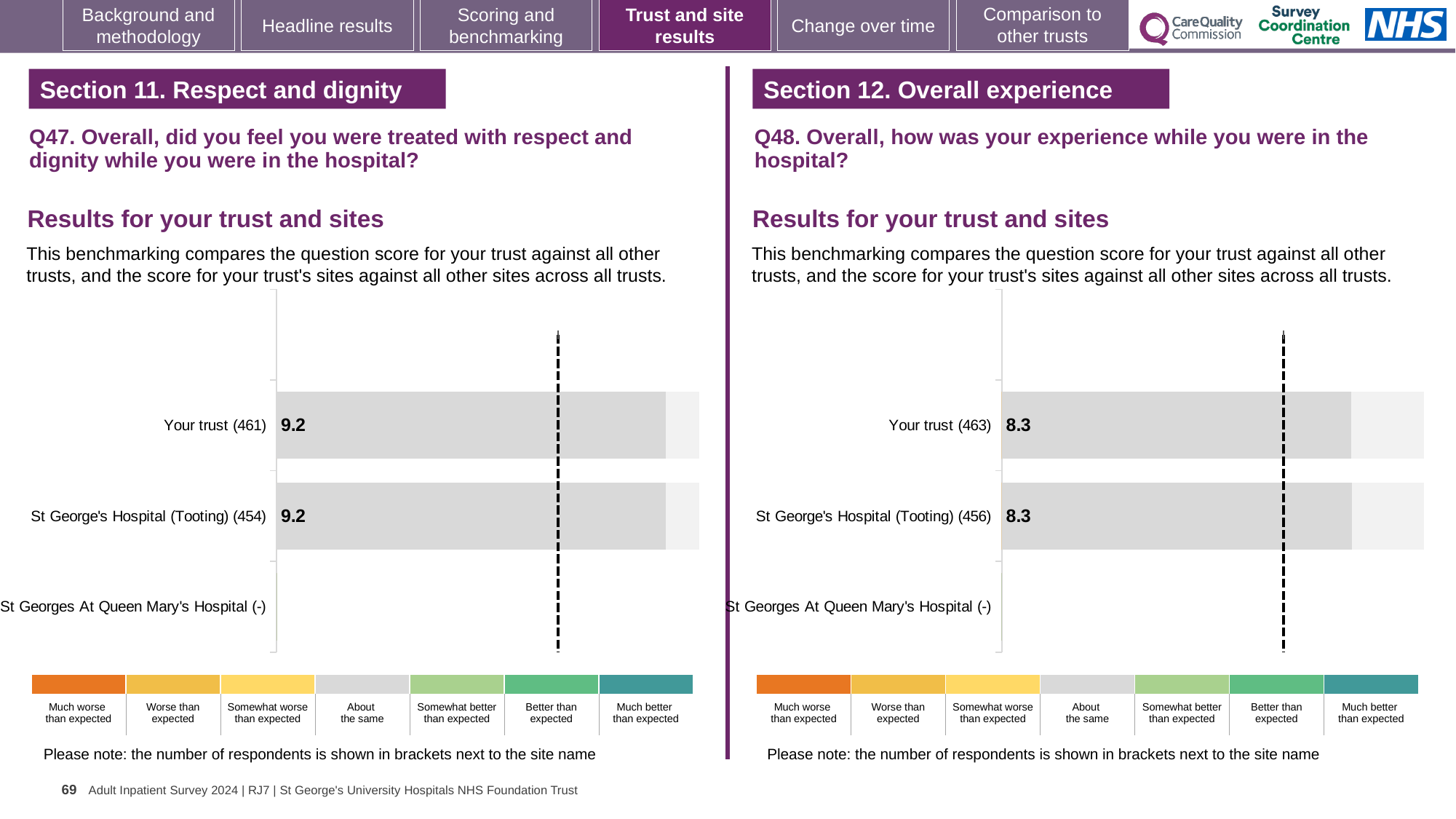
On the left chart (Q47), what is the score for St George's Hospital (Tooting)? 9.2 On the left chart (Q47), what is the score for Your trust? 9.2 On the right chart (Q48), what is the score for Your trust? 8.3 Is the score for Your trust on the left chart (Q47) larger or smaller than the score for Your trust on the right chart (Q48)? Larger What kind of chart is the left chart (Q47)? Bar chart On the left chart (Q47), what is the difference between the score for Your trust and the score for St George's Hospital (Tooting)? 0 How many categories are listed on the right chart (Q48)? 3 On the left chart (Q47), how many respondents are shown in brackets for Your trust? 461 On the left chart (Q47), which category has no score shown? St Georges At Queen Mary's Hospital (-) How many rating bands are shown in the colour key below the right chart (Q48)? 7 On the right chart (Q48), what is the score for St George's Hospital (Tooting)? 8.3 On the right chart (Q48), how many respondents are shown in brackets for St George's Hospital (Tooting)? 456